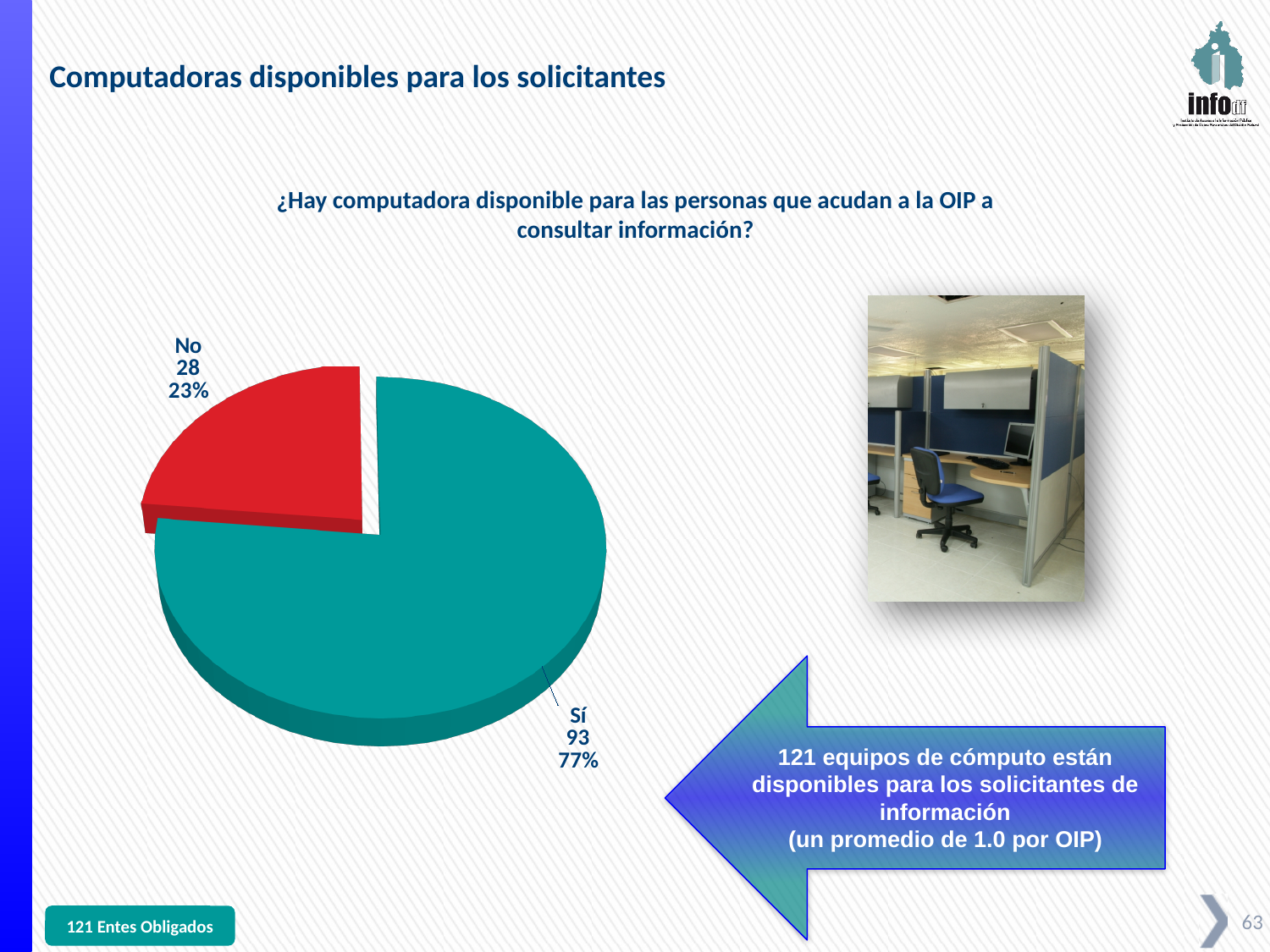
What colour is the "No" slice? red What percentage share does the "Sí" slice represent? 77% What kind of chart is shown on the slide? pie chart Which slice is the smallest? No What is the total of the two slice counts? 121 What percentage share does the "No" slice represent? 23% What is the count for the "No" slice? 28 What is the difference between the counts for "Sí" and "No"? 65 Which is larger, the count for "Sí" or the count for "No"? Sí Which slice is the largest? Sí What is the count for the "Sí" slice? 93 How many slices does the pie chart have? 2